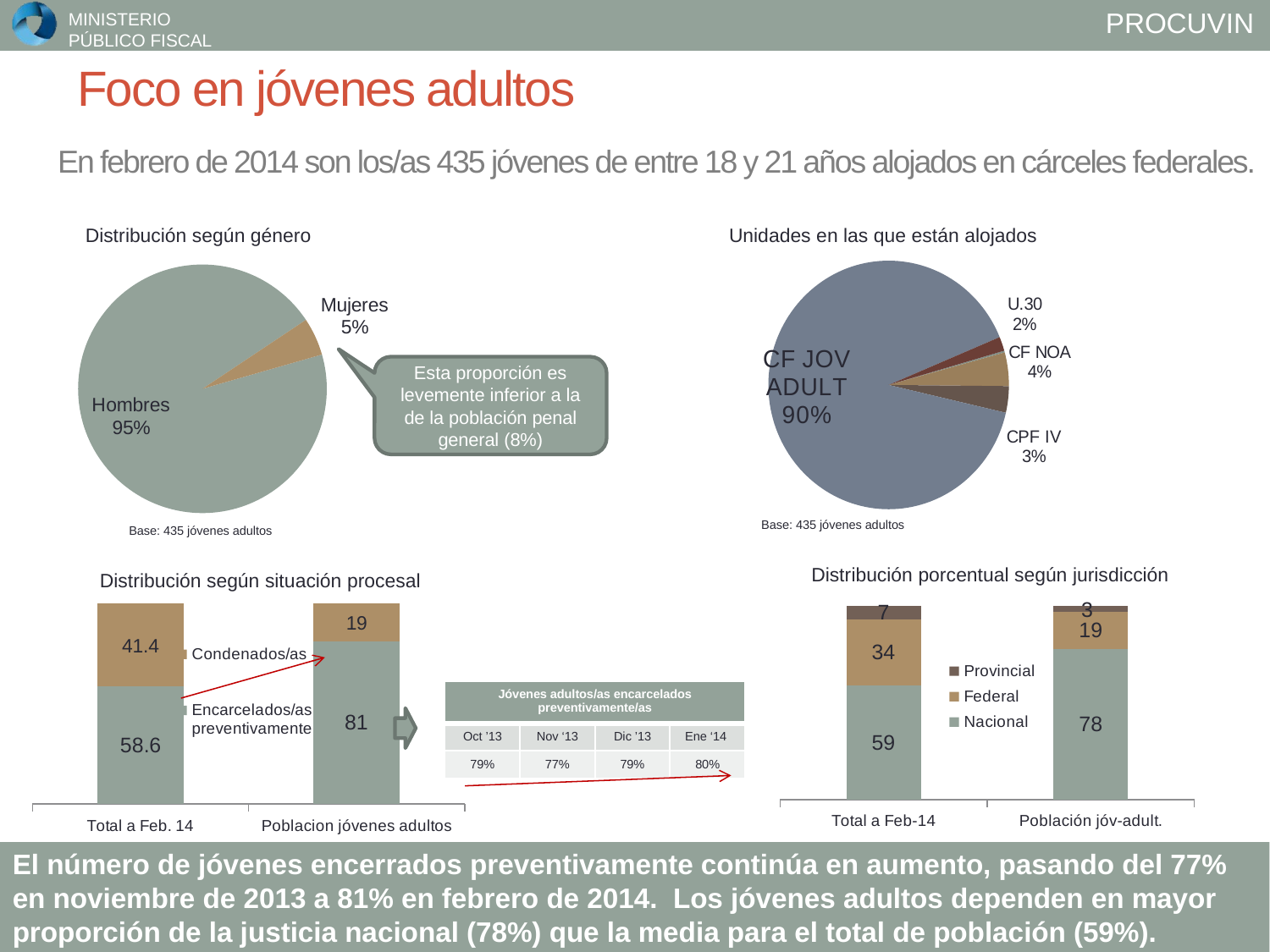
In the 'Distribución según situación procesal' bar chart, what is the total of the 'Poblacion jóvenes adultos' stacked bar? 100 How many series does the legend of the 'Distribución porcentual según jurisdicción' bar chart list? 3 In the 'Unidades en las que están alojados' pie chart, what share is CF NOA? 4% In the 'Distribución según situación procesal' bar chart, what is the value for Condenados/as in the 'Poblacion jóvenes adultos' bar? 19 What type of chart is 'Distribución porcentual según jurisdicción'? Stacked bar chart In the 'Distribución según género' pie chart, what share is Mujeres? 5% In the 'Distribución según situación procesal' bar chart, what is the value for Encarcelados/as preventivamente in the 'Total a Feb. 14' bar? 58.6 In the 'Distribución según género' pie chart, which category has the largest slice? Hombres In the 'Distribución porcentual según jurisdicción' bar chart, what is the Nacional value for 'Población jóv-adult.'? 78 In the 'Distribución porcentual según jurisdicción' bar chart, what is the difference between the Nacional values for 'Población jóv-adult.' and 'Total a Feb-14'? 19